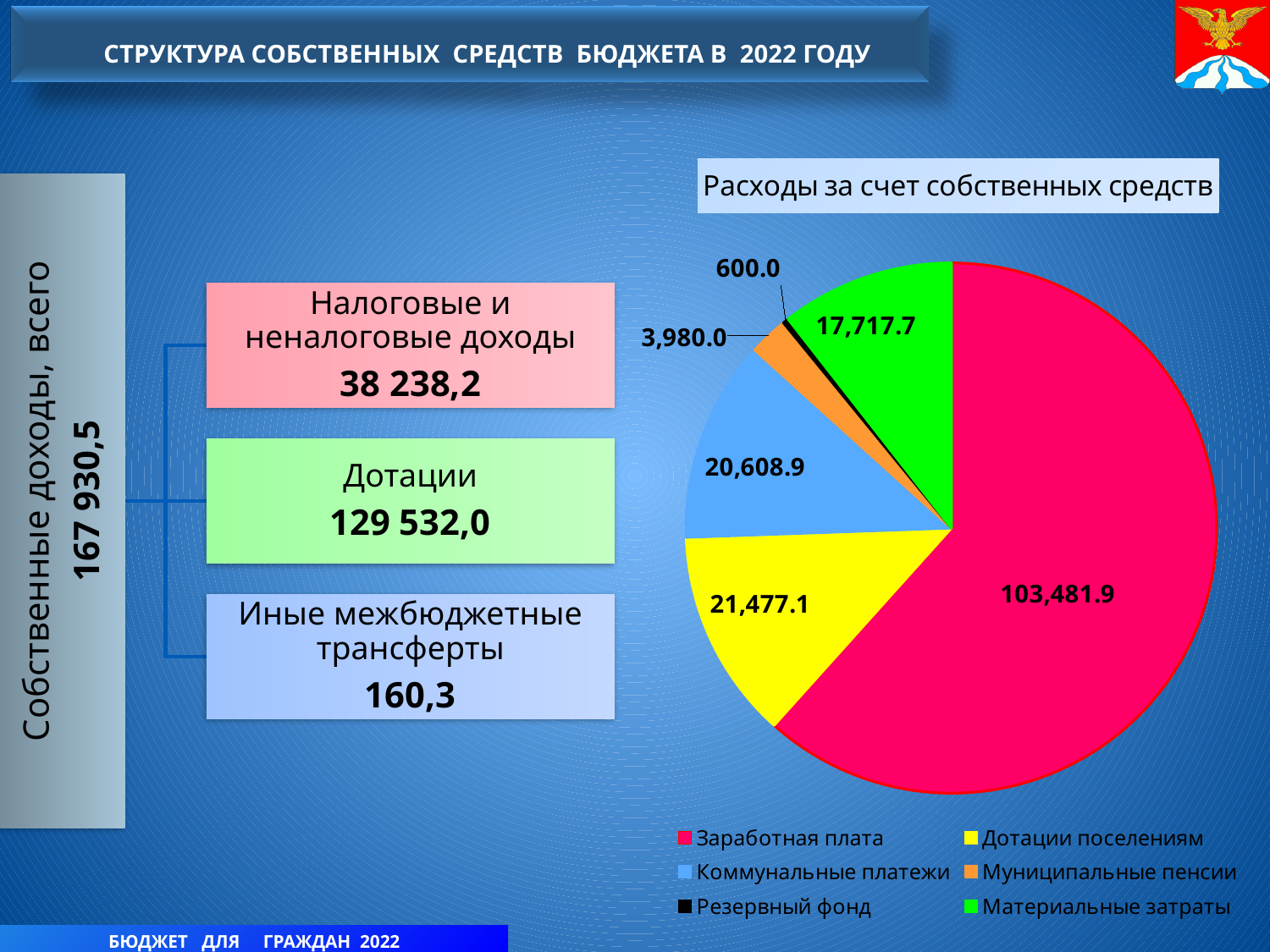
Which category has the largest slice in the pie chart? Заработная плата What is the value for Заработная плата in the pie chart? 103,481.9 What is the value for Материальные затраты in the pie chart? 17,717.7 What is the value for Коммунальные платежи in the pie chart? 20,608.9 What type of chart is shown on the slide? pie chart What is the value for Резервный фонд in the pie chart? 600.0 What is the value for Муниципальные пенсии in the pie chart? 3,980.0 What is the title of the pie chart? Расходы за счет собственных средств Which is larger: Дотации поселениям or Материальные затраты? Дотации поселениям How many categories does the pie chart legend list? 6 What is the difference between the values for Дотации поселениям and Коммунальные платежи? 868.2 Which category has the smallest slice in the pie chart? Резервный фонд